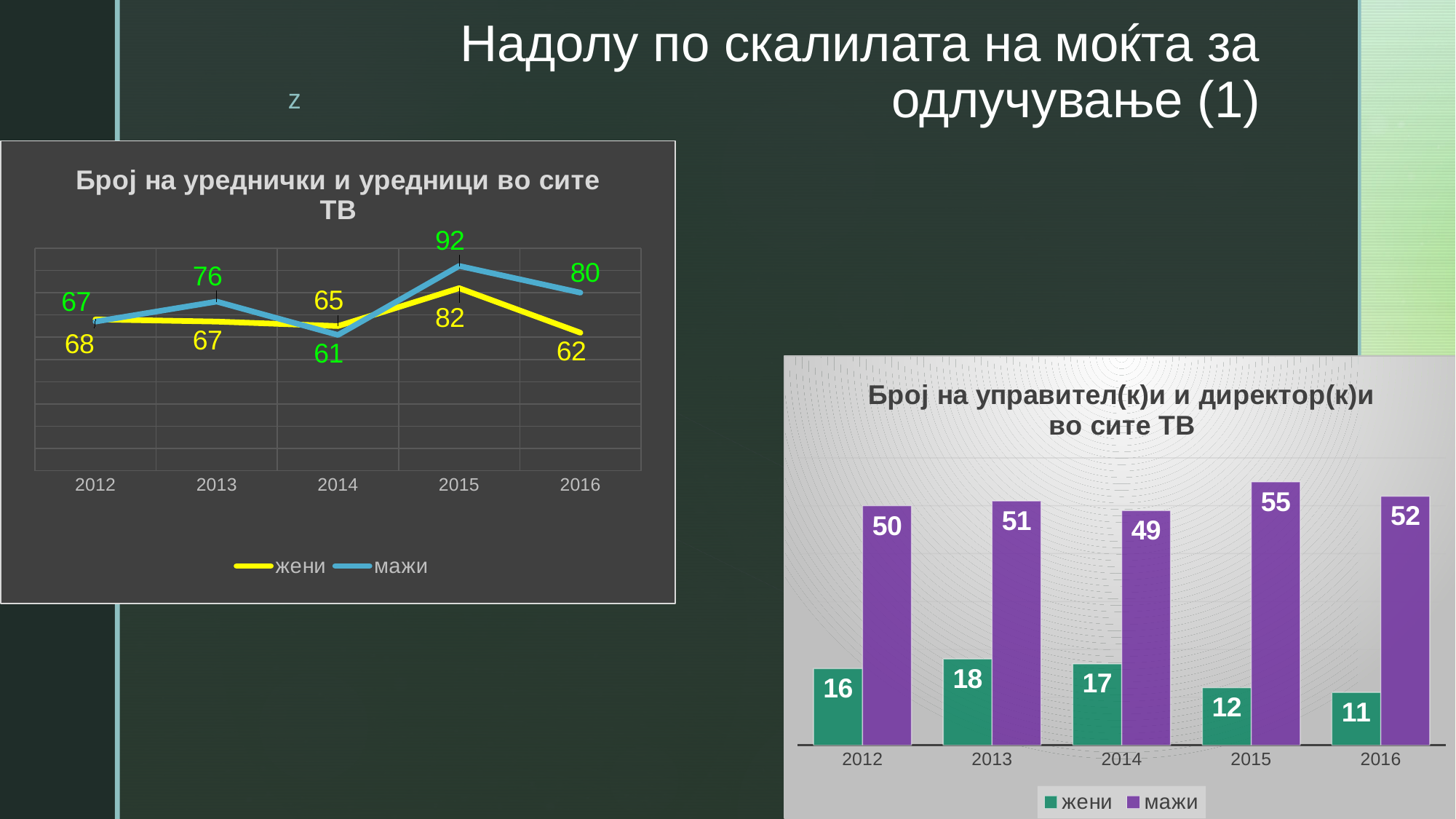
What kind of chart is 'Број на управител(к)и и директор(к)и во сите ТВ'? bar chart In the chart 'Број на уреднички и уредници во сите ТВ', in which year is the value for мажи highest? 2015 In the chart 'Број на уреднички и уредници во сите ТВ', what is the value for мажи in 2014? 61 In the chart 'Број на уреднички и уредници во сите ТВ', what is the difference between мажи and жени in 2016? 18 In the chart 'Број на уреднички и уредници во сите ТВ', in which year is the value for жени lowest? 2016 In the chart 'Број на уреднички и уредници во сите ТВ', what is the value for жени in 2015? 82 What kind of chart is 'Број на уреднички и уредници во сите ТВ'? line chart In the chart 'Број на управител(к)и и директор(к)и во сите ТВ', what is the difference between мажи and жени in 2012? 34 In the chart 'Број на управител(к)и и директор(к)и во сите ТВ', what is the value for мажи in 2015? 55 In the chart 'Број на управител(к)и и директор(к)и во сите ТВ', in which year is the value for мажи lowest? 2014 In the chart 'Број на управител(к)и и директор(к)и во сите ТВ', what is the value for жени in 2013? 18 In the chart 'Број на управител(к)и и директор(к)и во сите ТВ', how many years are shown on the x axis? 5